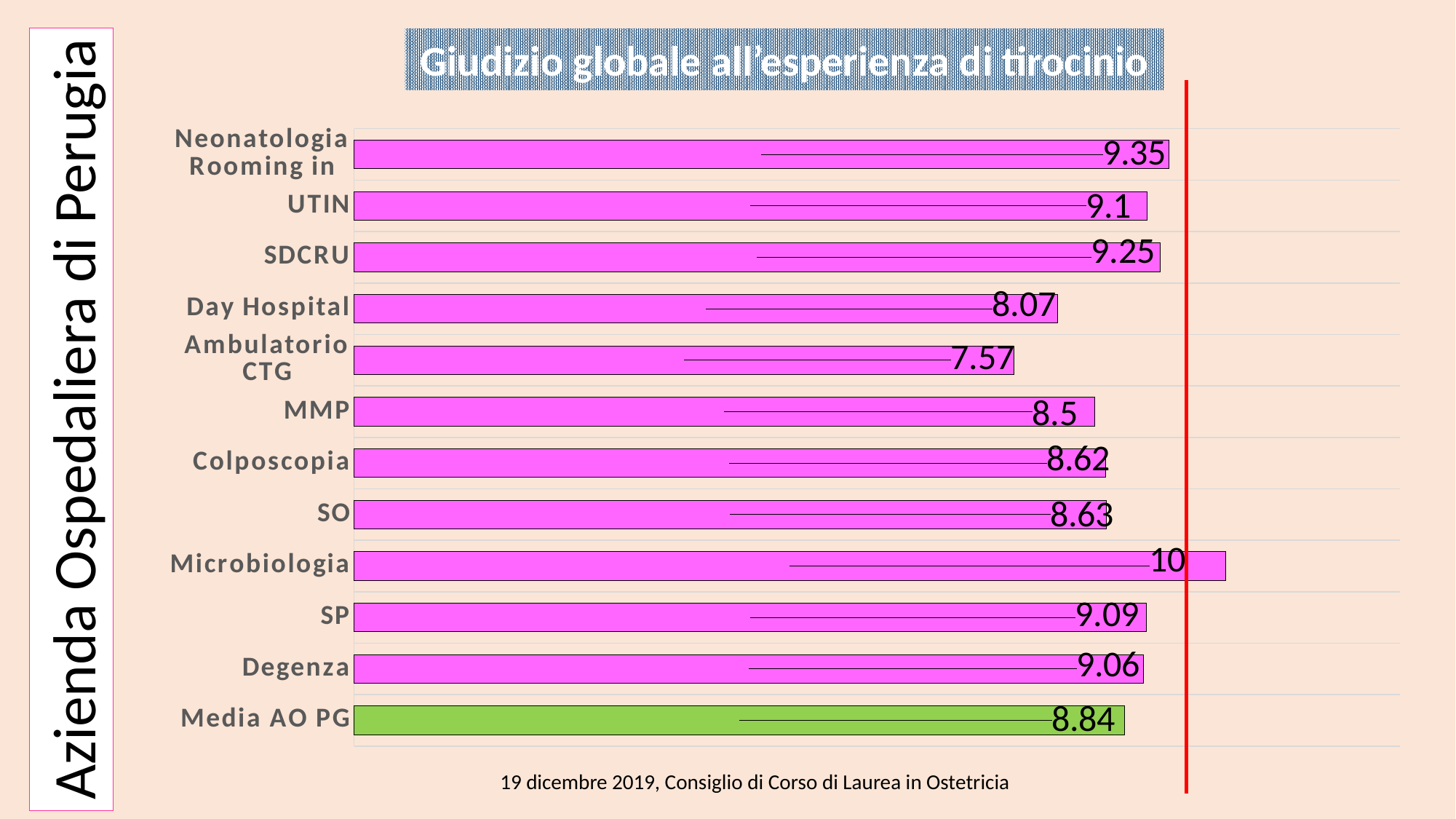
What kind of chart is shown on the slide? Bar chart What is the value for Microbiologia? 10 How many categories are shown in the chart? 12 What is the value for Media AO PG? 8.84 What is the value for Ambulatorio CTG? 7.57 Which category has the lowest value? Ambulatorio CTG What is the difference between the values for Neonatologia Rooming in and UTIN? 0.25 What is the title of the chart? Giudizio globale all'esperienza di tirocinio What is the difference between the values for Microbiologia and Ambulatorio CTG? 2.43 Which is larger, the value for SDCRU or the value for Day Hospital? SDCRU Which category has the highest value? Microbiologia What is the value for Neonatologia Rooming in? 9.35